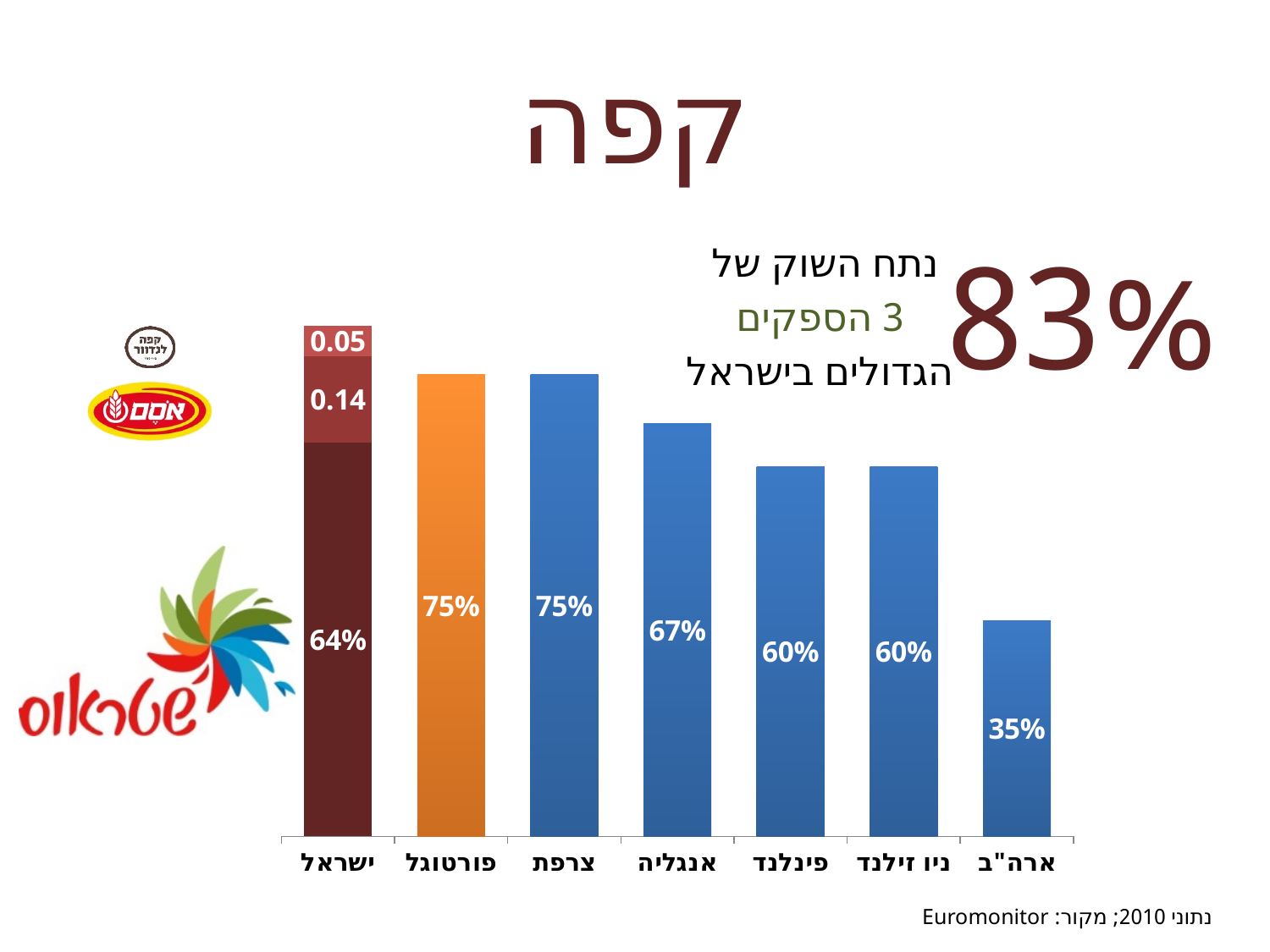
What is the value of the topmost segment of the ישראל (Israel) bar? 0.05 What is the value of the bottom (largest) segment of the ישראל (Israel) bar? 64% What is the value shown for פורטוגל (Portugal)? 75% Do the bar values generally rise or fall from left to right across the chart? Fall What is the difference between the values for צרפת (France) and ארה"ב (USA)? 40 percentage points Which country has the lowest value in the chart? ארה"ב (USA) How many countries are shown on the x axis of the chart? 7 What is the value shown for ארה"ב (USA)? 35% What kind of chart is shown on the slide? Bar chart Which has a larger value, אנגליה (England) or פינלנד (Finland)? אנגליה (England) According to the slide, what is the total market share of the 3 largest suppliers in Israel? 83% What is the value shown for אנגליה (England)? 67%